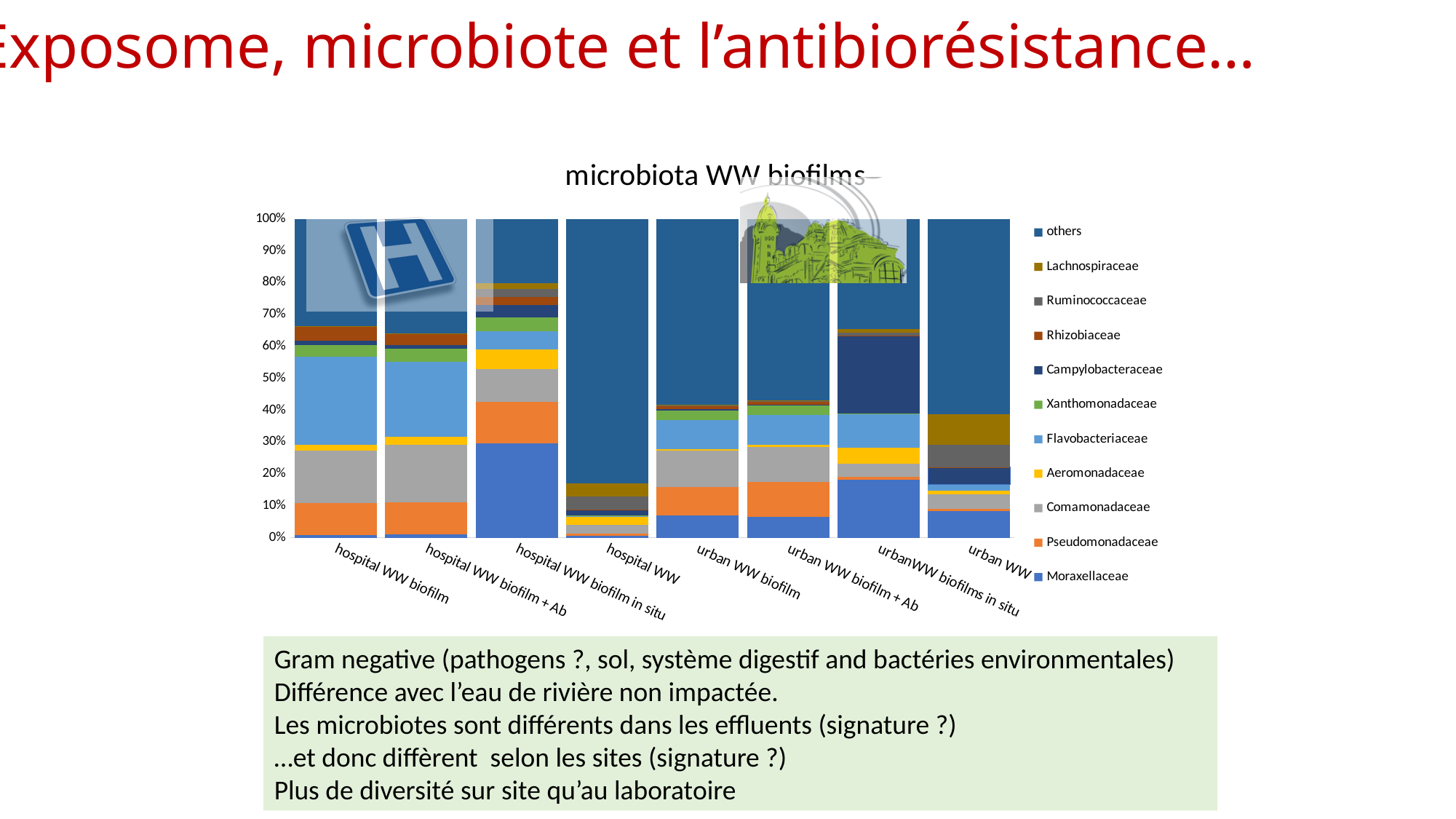
Which bar has the smallest 'others' share? hospital WW biofilm in situ How many bars (sample categories) are shown on the x axis of the chart? 8 Is the Flavobacteriaceae share in the 'hospital WW biofilm' bar greater or less than 20%? greater Which bar has the larger Moraxellaceae share: 'hospital WW biofilm in situ' or 'urbanWW biofilms in situ'? hospital WW biofilm in situ Which series is listed last (at the bottom) in the chart legend? Moraxellaceae Is the Moraxellaceae share in the 'hospital WW biofilm in situ' bar greater or less than 20%? greater Is the Campylobacteraceae share in the 'urbanWW biofilms in situ' bar greater or less than 40%? less What is the title of the chart? microbiota WW biofilms Which bar has the largest 'others' share? hospital WW How many series does the chart legend list? 11 What kind of chart is shown on the slide? stacked bar chart